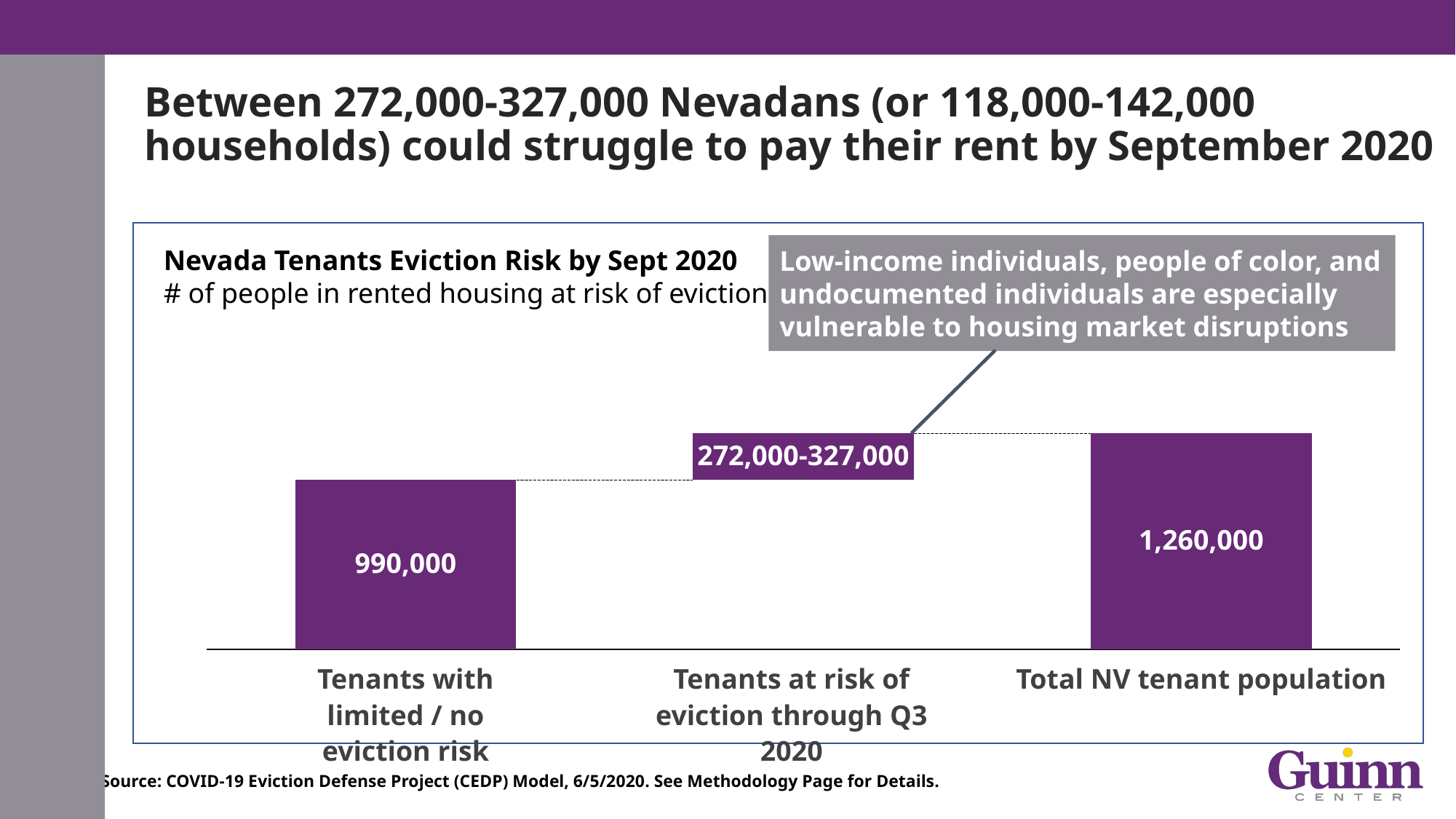
What is the difference between Total NV tenant population and Tenants with limited / no eviction risk? 270,000 Which category has the highest value? Total NV tenant population Which category has the lowest value? Tenants at risk of eviction through Q3 2020 What is the title of the chart? Nevada Tenants Eviction Risk by Sept 2020 What does the chart subtitle say the chart measures? # of people in rented housing at risk of eviction What is the value for Total NV tenant population? 1,260,000 Which is larger: Tenants with limited / no eviction risk or Total NV tenant population? Total NV tenant population How many categories are shown on the x axis? 3 What kind of chart is shown on the slide? Bar chart What is the value for Tenants with limited / no eviction risk? 990,000 What value is shown for Tenants at risk of eviction through Q3 2020? 272,000-327,000